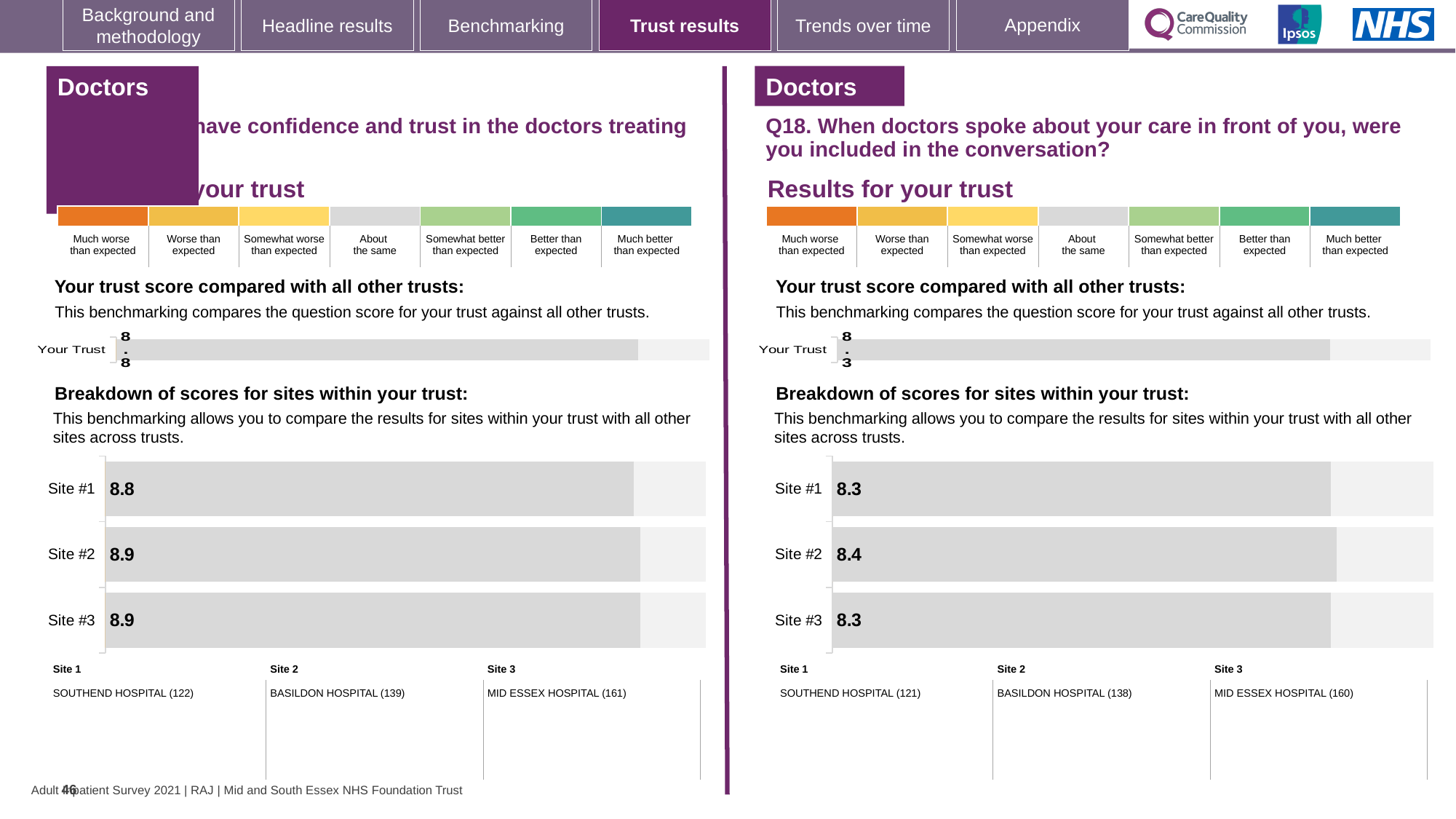
How many sites are shown in the site breakdown on the Q18 chart on the right? 3 On the left-hand chart, what is the score for Site #1? 8.8 On the left-hand chart, what is the score shown for Your Trust? 8.8 On the left-hand chart, what is the score for Site #3? 8.9 What type of chart is used for the breakdown of scores for sites on the left-hand side? bar chart On the Q18 chart on the right, what is the score shown for Your Trust? 8.3 On the Q18 chart on the right, which hospital is listed as Site 3? MID ESSEX HOSPITAL (160) On the Q18 chart on the right, which site has the highest score? Site #2 Is the Site #1 score on the left-hand chart larger or smaller than the Site #1 score on the Q18 chart on the right? larger On the left-hand chart, which site has the lowest score? Site #1 On the Q18 chart on the right, what is the score for Site #2? 8.4 On the Q18 chart on the right, what is the difference between the scores for Site #2 and Site #1? 0.1